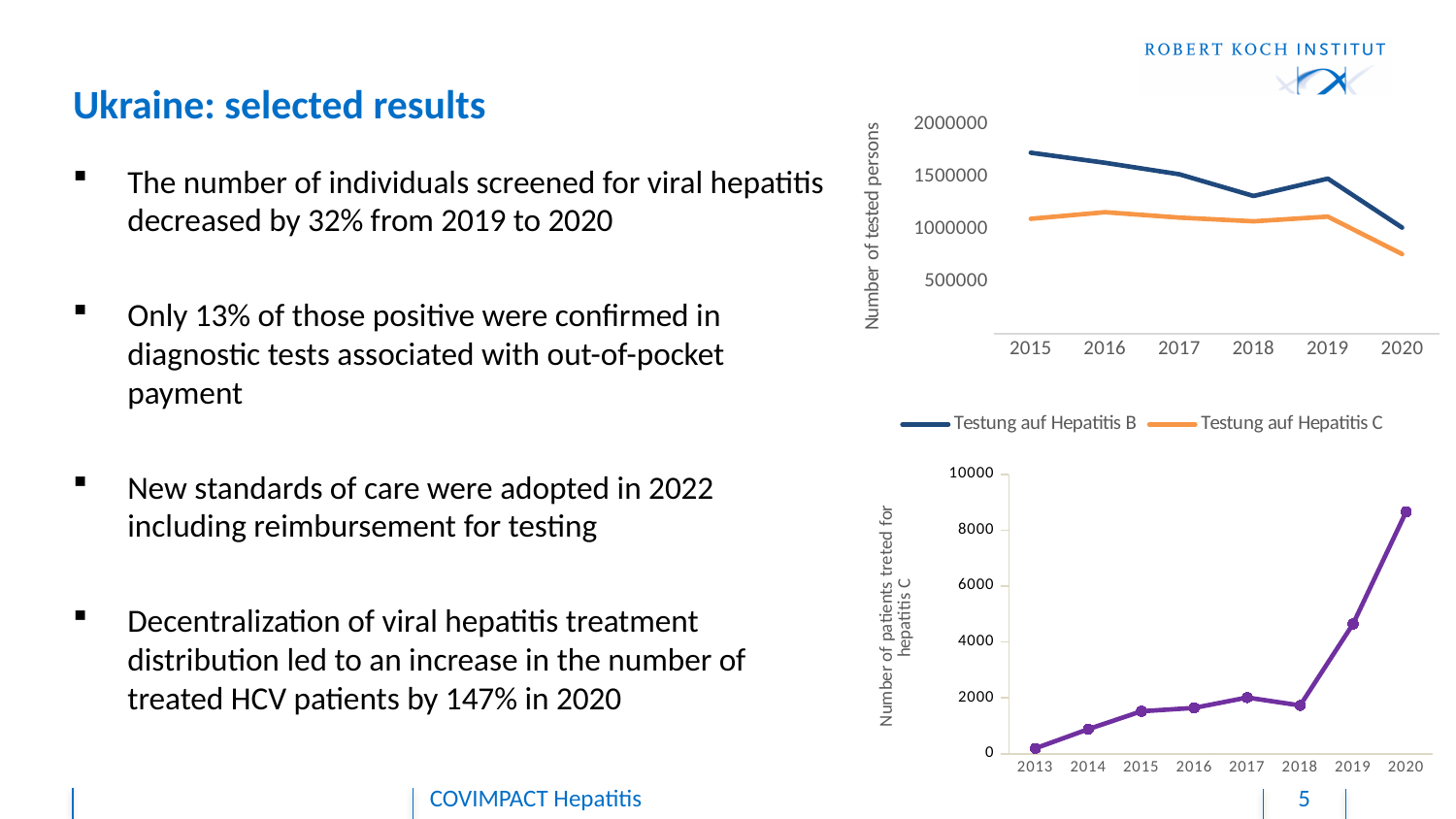
In the top chart, in which year is Testung auf Hepatitis B highest? 2015 How many years are shown on the x axis of the top chart? 6 How many series does the legend of the top chart list? 2 In the bottom chart, in which year is the number of patients treated for hepatitis C lowest? 2013 What kind of chart is the top chart on the slide? line chart How many data points are plotted in the bottom chart? 8 In the top chart, which series has the higher value in 2015, Testung auf Hepatitis B or Testung auf Hepatitis C? Testung auf Hepatitis B In the bottom chart, in which year is the number of patients treated for hepatitis C highest? 2020 In the bottom chart, is the value for 2020 greater or less than 8000? greater In the bottom chart, do the values generally rise or fall from 2013 to 2020? rise In the top chart, is the value for Testung auf Hepatitis B in 2015 greater or less than 1500000? greater In the top chart, is the value for Testung auf Hepatitis C in 2020 greater or less than 1000000? less